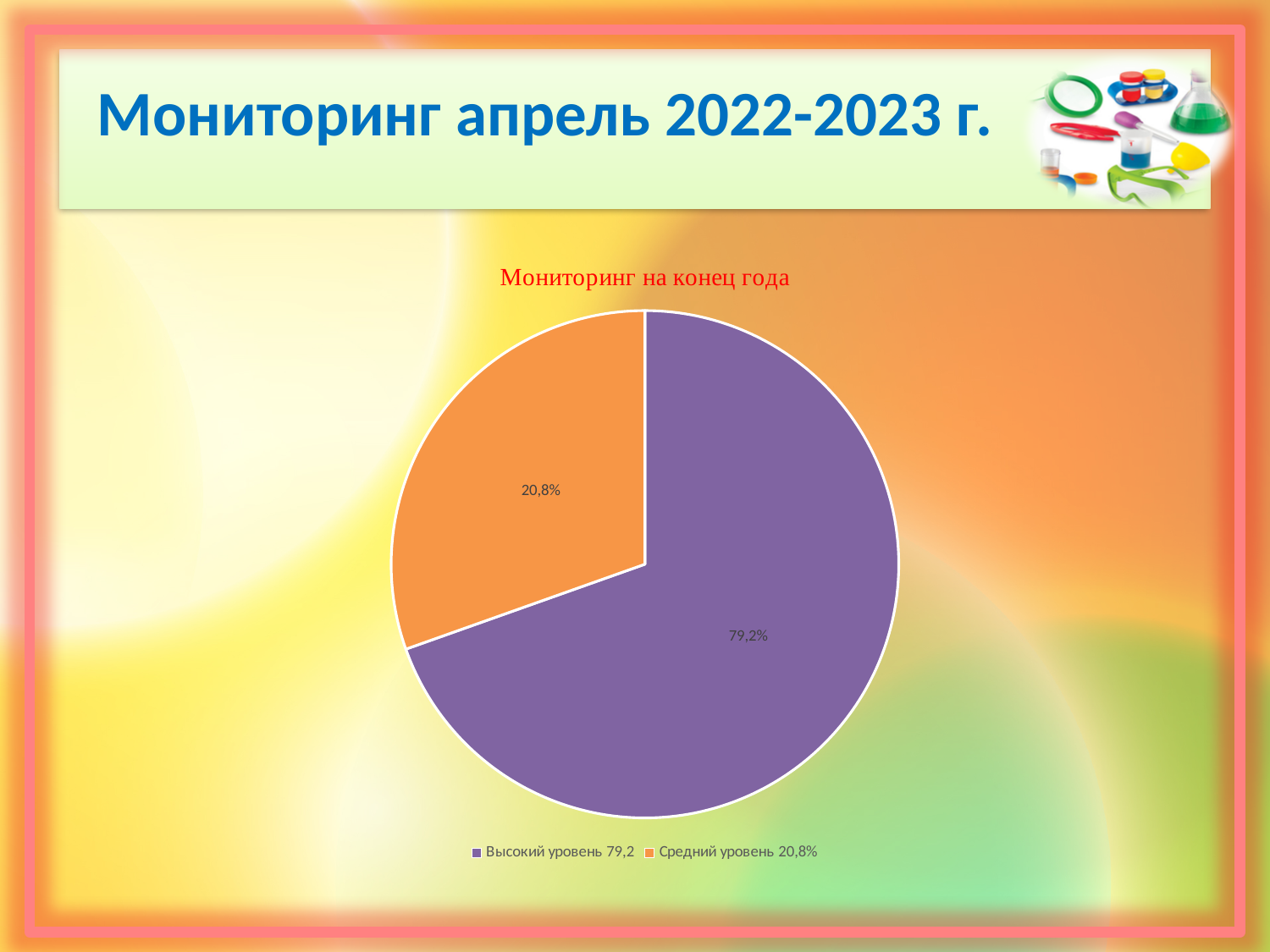
Which is larger, the Высокий уровень slice or the Средний уровень slice? Высокий уровень What is the difference in percentage points between the Высокий уровень slice and the Средний уровень slice? 58,4 Which slice is the largest in the pie chart? Высокий уровень How many entries does the legend list? 2 What is the title of the chart? Мониторинг на конец года What percentage is shown for the purple slice (Высокий уровень)? 79,2% Which slice is the smallest in the pie chart? Средний уровень What kind of chart is shown on the slide? pie chart What share of the pie does the Высокий уровень slice represent? 79,2% How many slices does the pie chart have? 2 What percentage is shown for the orange slice (Средний уровень)? 20,8% What colour is the Средний уровень slice? orange